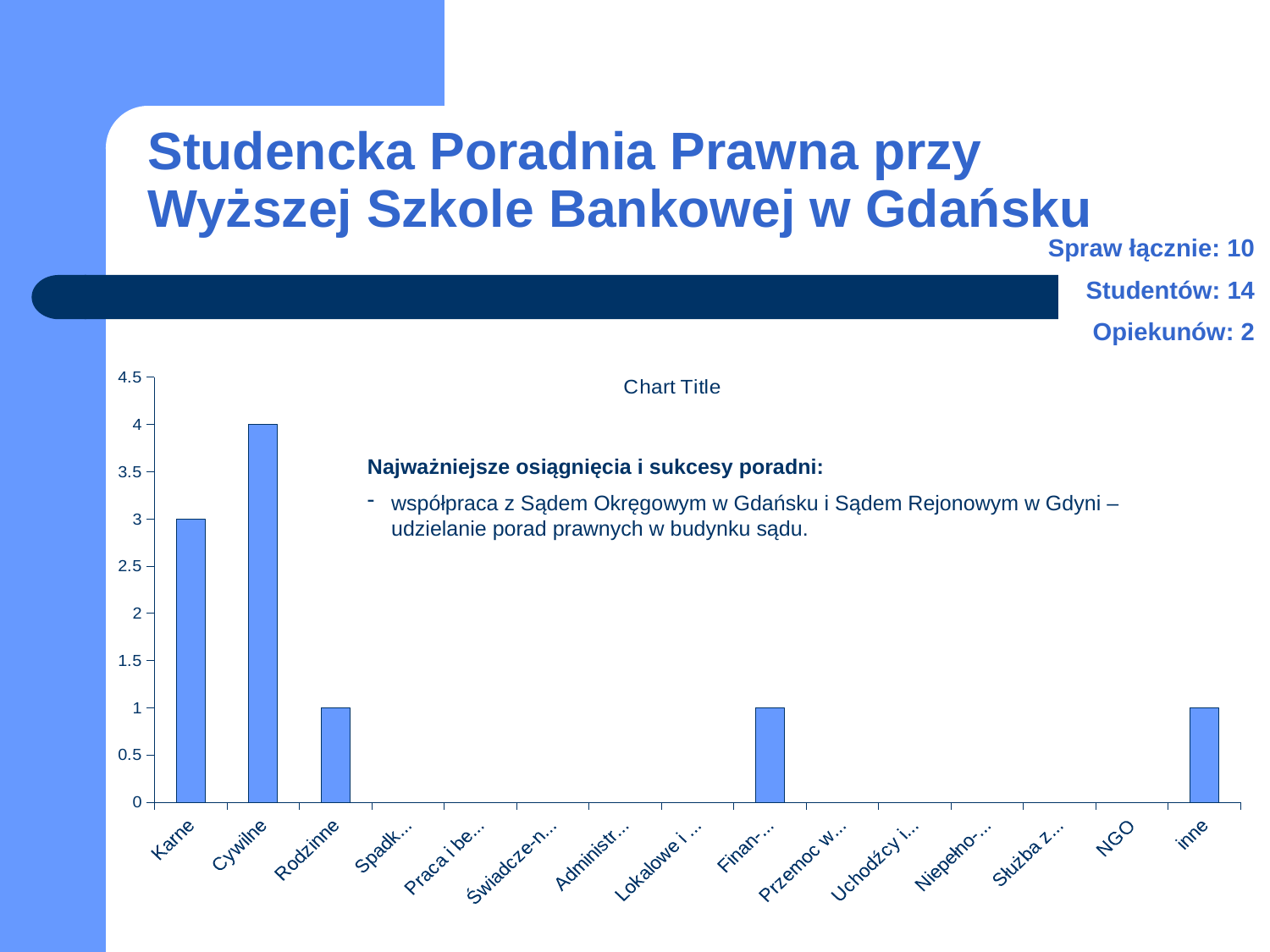
What is the title of the chart? Chart Title What is the difference between the values for Cywilne and Karne? 1 What is the value for Karne? 3 What is the value for Cywilne? 4 Is the value for Karne greater or less than 2? greater Which category has the highest value? Cywilne Is the value for NGO greater or less than 1? less What is the value for Rodzinne? 1 How many categories are shown on the x axis? 15 What is the value for inne? 1 Which is larger, the value for Karne or the value for Rodzinne? Karne What kind of chart is shown on the slide? bar chart